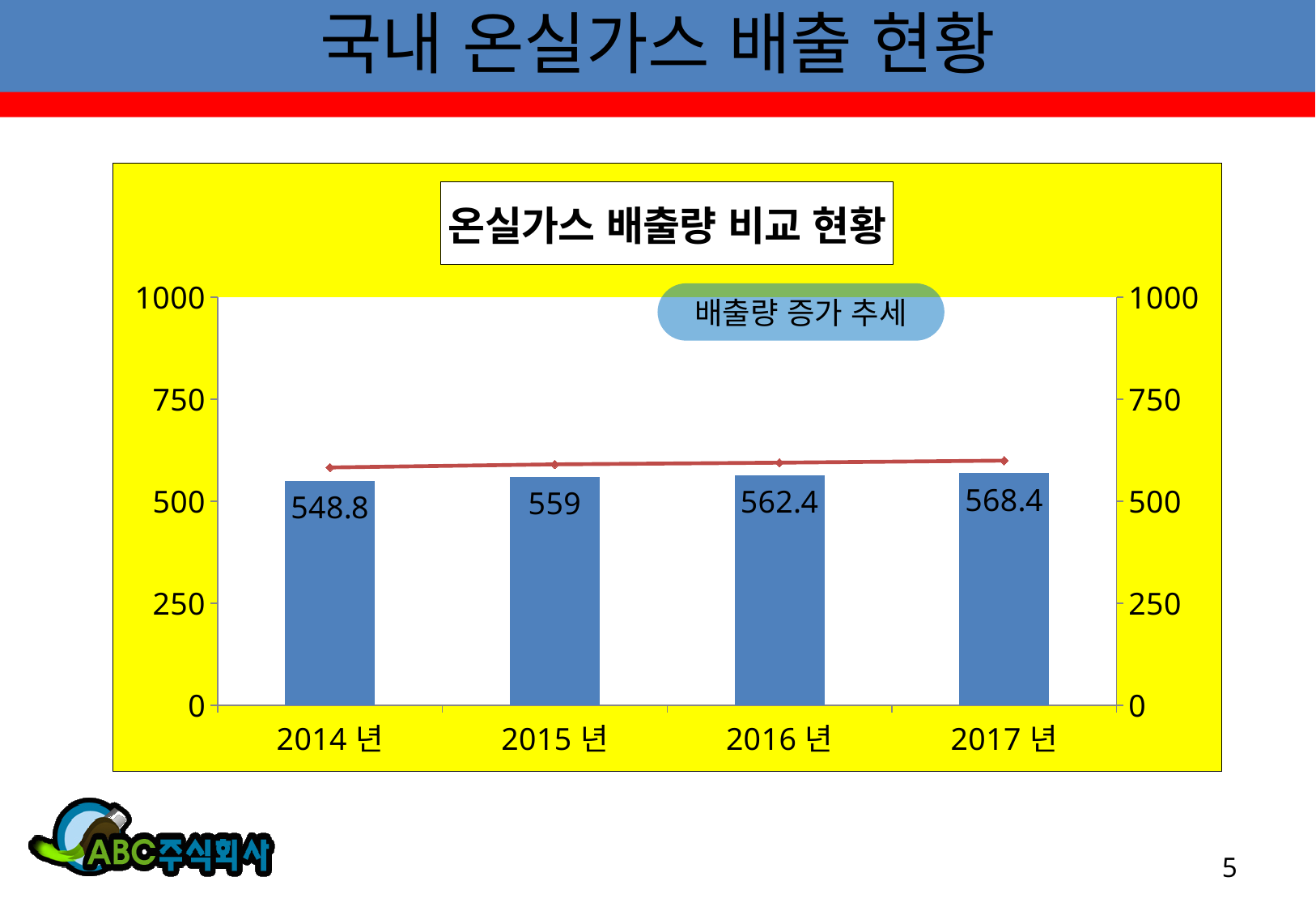
Which year has the lowest bar value? 2014 년 What is the value for 2016 년? 562.4 What is the value for 2015 년? 559 What is the title of the chart? 온실가스 배출량 비교 현황 Which is larger, the value for 2015 년 or the value for 2016 년? 2016 년 What is the difference between the values for 2017 년 and 2014 년? 19.6 What is the value for 2017 년? 568.4 Which year has the highest bar value? 2017 년 Is the value for 2014 년 greater or less than 500? greater How many years are shown on the x axis? 4 What is the value for 2014 년? 548.8 Do the bar values rise or fall from 2014 년 to 2017 년? rise